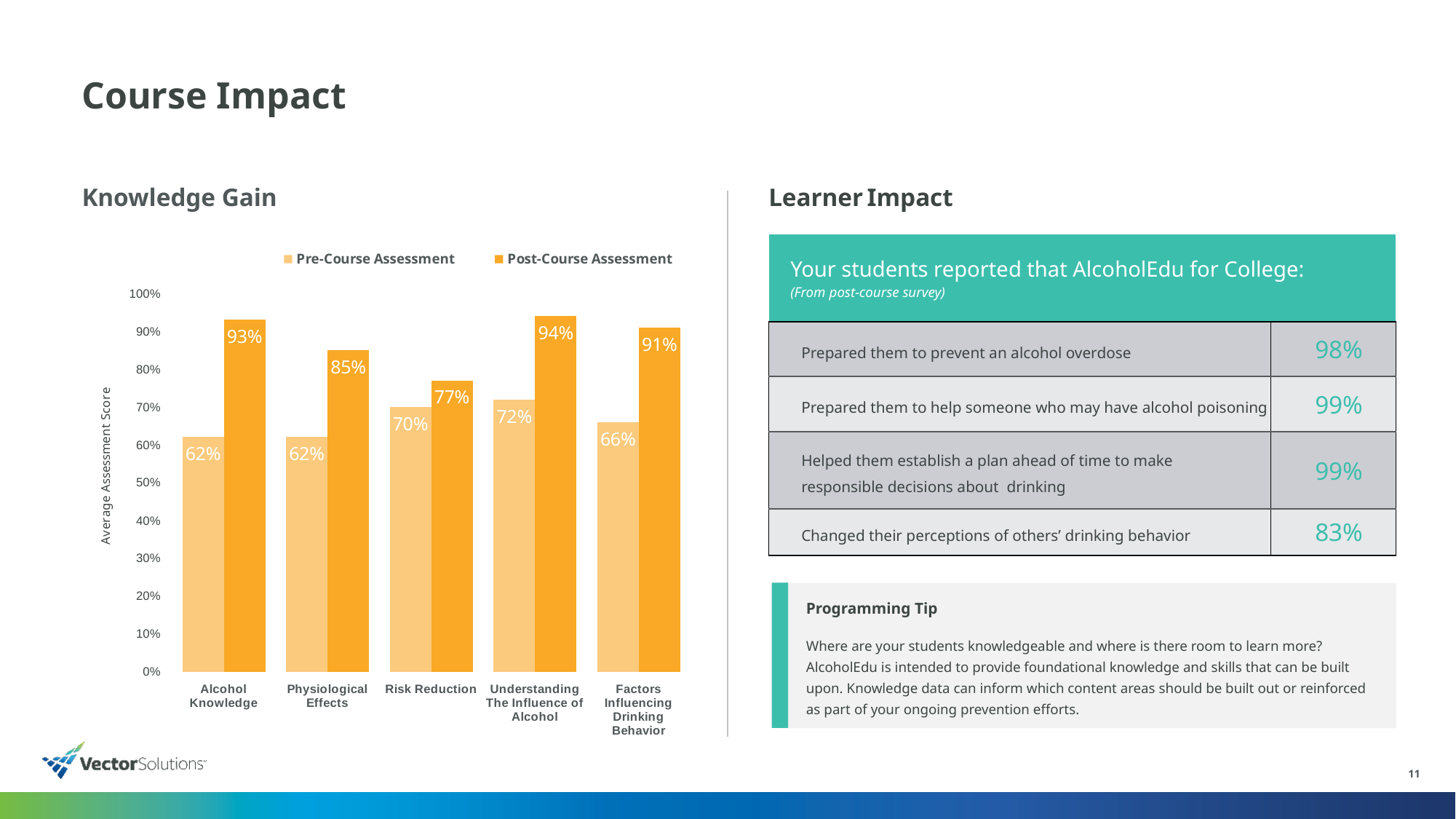
How many categories are shown on the x axis of the chart? 5 How many series does the chart legend list? 2 Which is larger: the Pre-Course Assessment value for Understanding The Influence of Alcohol or for Factors Influencing Drinking Behavior? Understanding The Influence of Alcohol Which category has the lowest Post-Course Assessment value? Risk Reduction What is the difference between the Post-Course and Pre-Course Assessment values for Physiological Effects? 23% What is the Post-Course Assessment value for Factors Influencing Drinking Behavior? 91% What is the Post-Course Assessment value for Alcohol Knowledge? 93% What is the Pre-Course Assessment value for Risk Reduction? 70% What kind of chart is shown under Knowledge Gain? Bar chart Is the Post-Course Assessment value for Risk Reduction greater or less than 80%? less Which category has the highest Post-Course Assessment value? Understanding The Influence of Alcohol What is the label on the vertical axis of the chart? Average Assessment Score